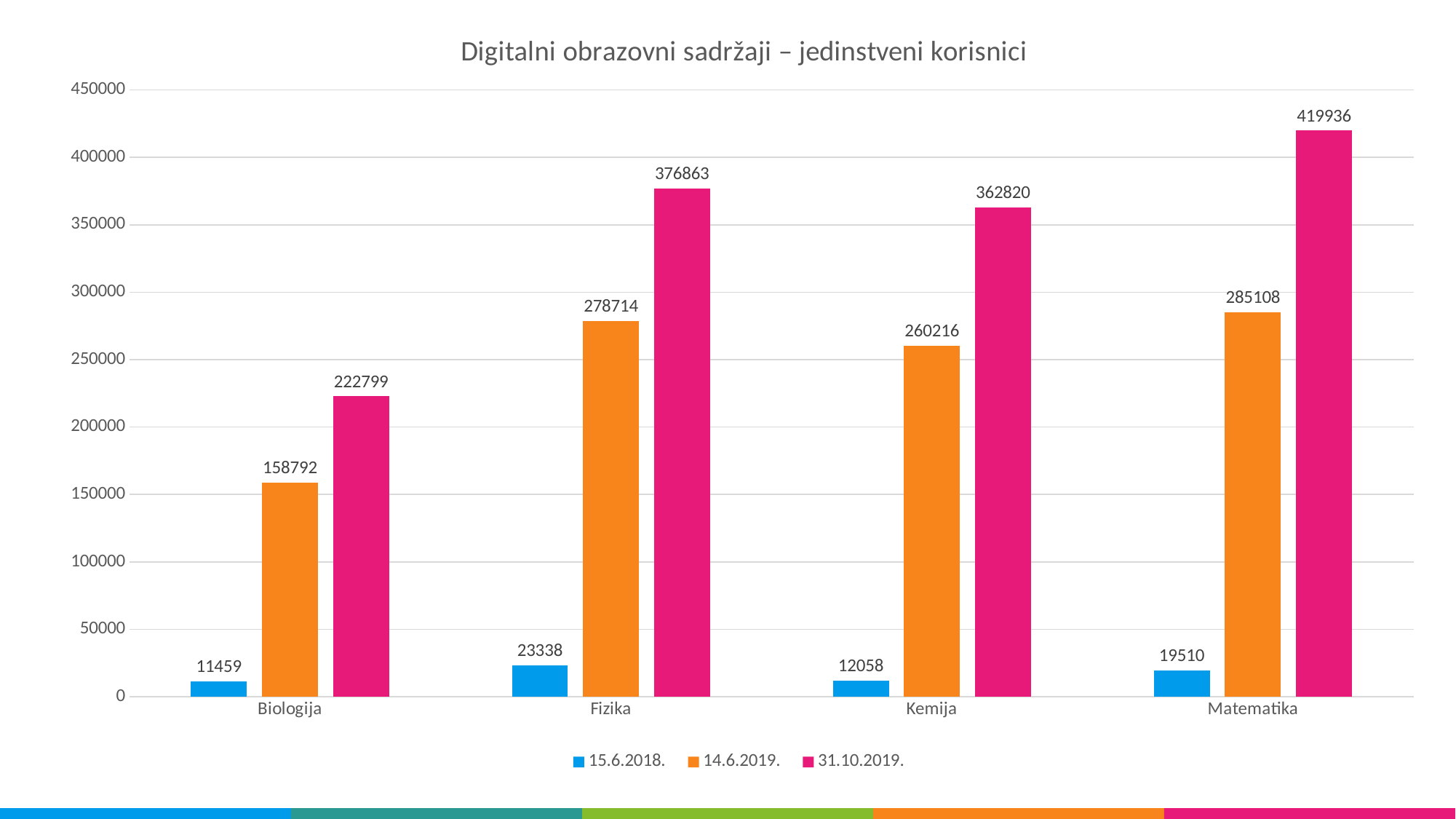
Which colour represents the 31.10.2019. series? pink Which category has the highest value in the 31.10.2019. series? Matematika How many categories are shown on the x axis? 4 What is the value for Kemija in the 15.6.2018. series? 12058 What is the difference between the 31.10.2019. and 14.6.2019. values for Matematika? 134828 Which is larger: the 14.6.2019. value for Kemija or the 14.6.2019. value for Fizika? Fizika What kind of chart is shown on the slide? bar chart What is the value for Fizika in the 14.6.2019. series? 278714 How many series does the legend list? 3 What is the value for Biologija in the 31.10.2019. series? 222799 Which category has the lowest value in the 15.6.2018. series? Biologija What is the title of the chart? Digitalni obrazovni sadržaji – jedinstveni korisnici